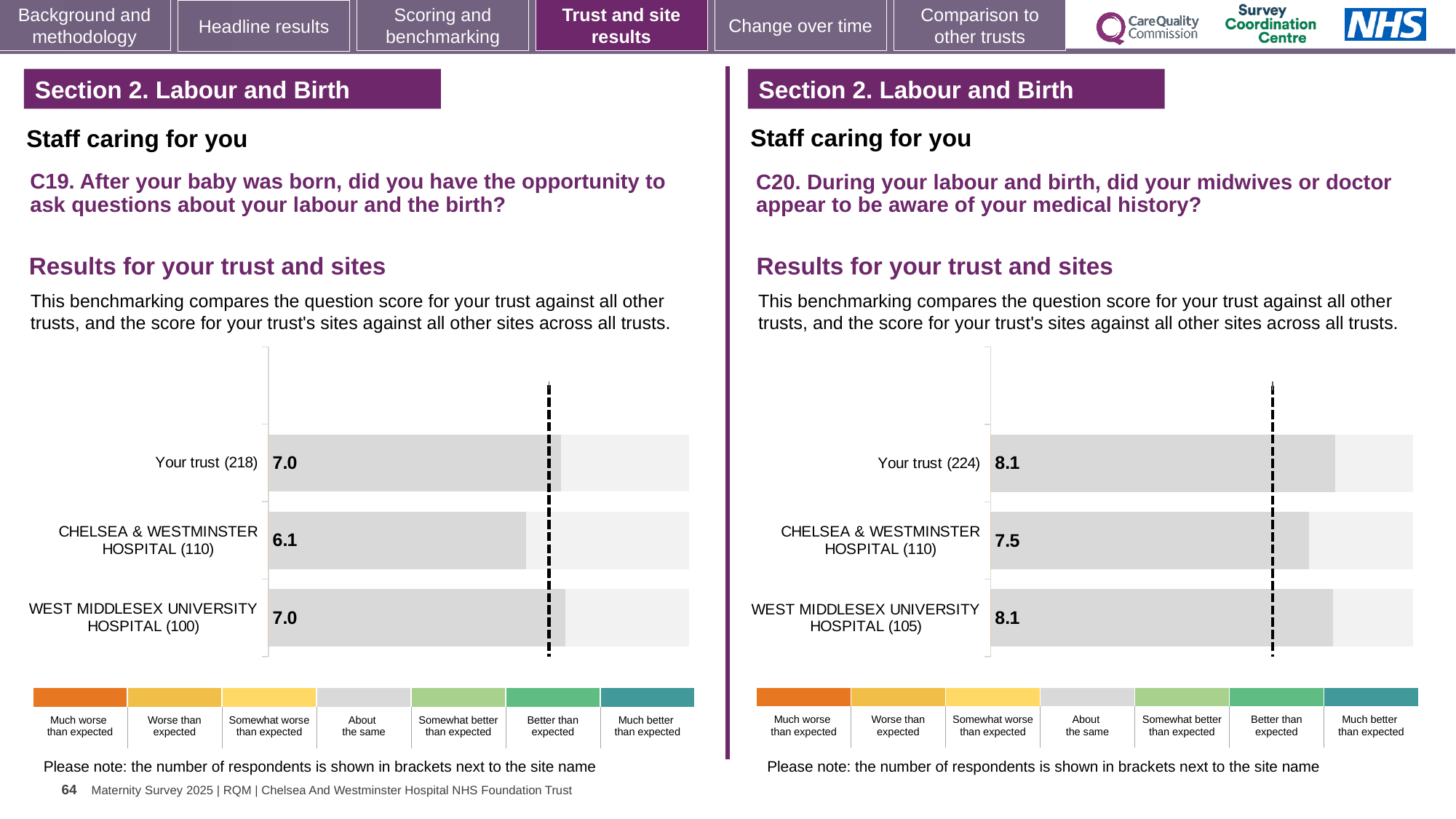
In the C20 chart on the right, which site or trust has the lowest score? CHELSEA & WESTMINSTER HOSPITAL (110) In the C19 chart on the left, what is the difference between the score for WEST MIDDLESEX UNIVERSITY HOSPITAL (100) and CHELSEA & WESTMINSTER HOSPITAL (110)? 0.9 What type of chart is used for the C19 results on the left? Bar chart In the C19 chart on the left, what is the score for CHELSEA & WESTMINSTER HOSPITAL (110)? 6.1 In the C20 chart on the right, which has the larger score: Your trust (224) or CHELSEA & WESTMINSTER HOSPITAL (110)? Your trust (224) In the C20 chart on the right, what is the difference between the score for Your trust (224) and CHELSEA & WESTMINSTER HOSPITAL (110)? 0.6 In the C19 chart on the left, how many bars are plotted? 3 In the C20 chart on the right, what is the score for Your trust (224)? 8.1 In the C20 chart on the right, what is the score for CHELSEA & WESTMINSTER HOSPITAL (110)? 7.5 In the C20 chart on the right, what is the score for WEST MIDDLESEX UNIVERSITY HOSPITAL (105)? 8.1 In the C19 chart on the left, which site or trust has the lowest score? CHELSEA & WESTMINSTER HOSPITAL (110) In the C19 chart on the left, what is the score for Your trust (218)? 7.0